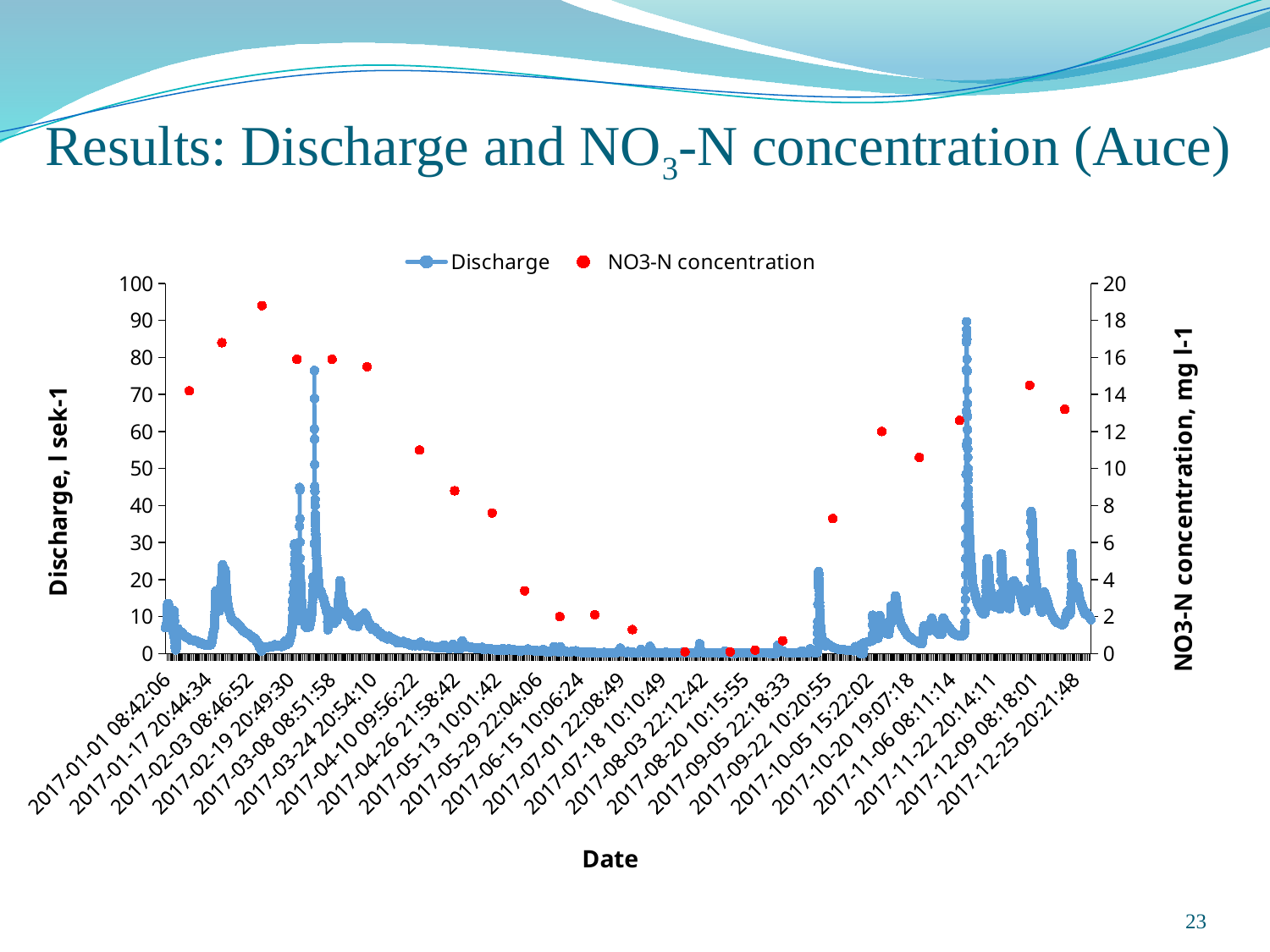
What is the title of the left vertical axis? Discharge, l sek-1 How many series does the legend list? 2 Are the NO3-N concentration values in August 2017 greater or less than 2? less What are the two series named in the legend? Discharge and NO3-N concentration Do the NO3-N concentration values rise or fall from February 2017 to August 2017? Fall Is the highest NO3-N concentration value greater or less than 15? greater In which month of 2017 does the Discharge series reach its highest peak? November Is the Discharge value at the start of the series (2017-01-01) greater or less than 30? less What kind of chart is shown on the slide? Line chart Do the NO3-N concentration values rise or fall from August 2017 to November 2017? Rise